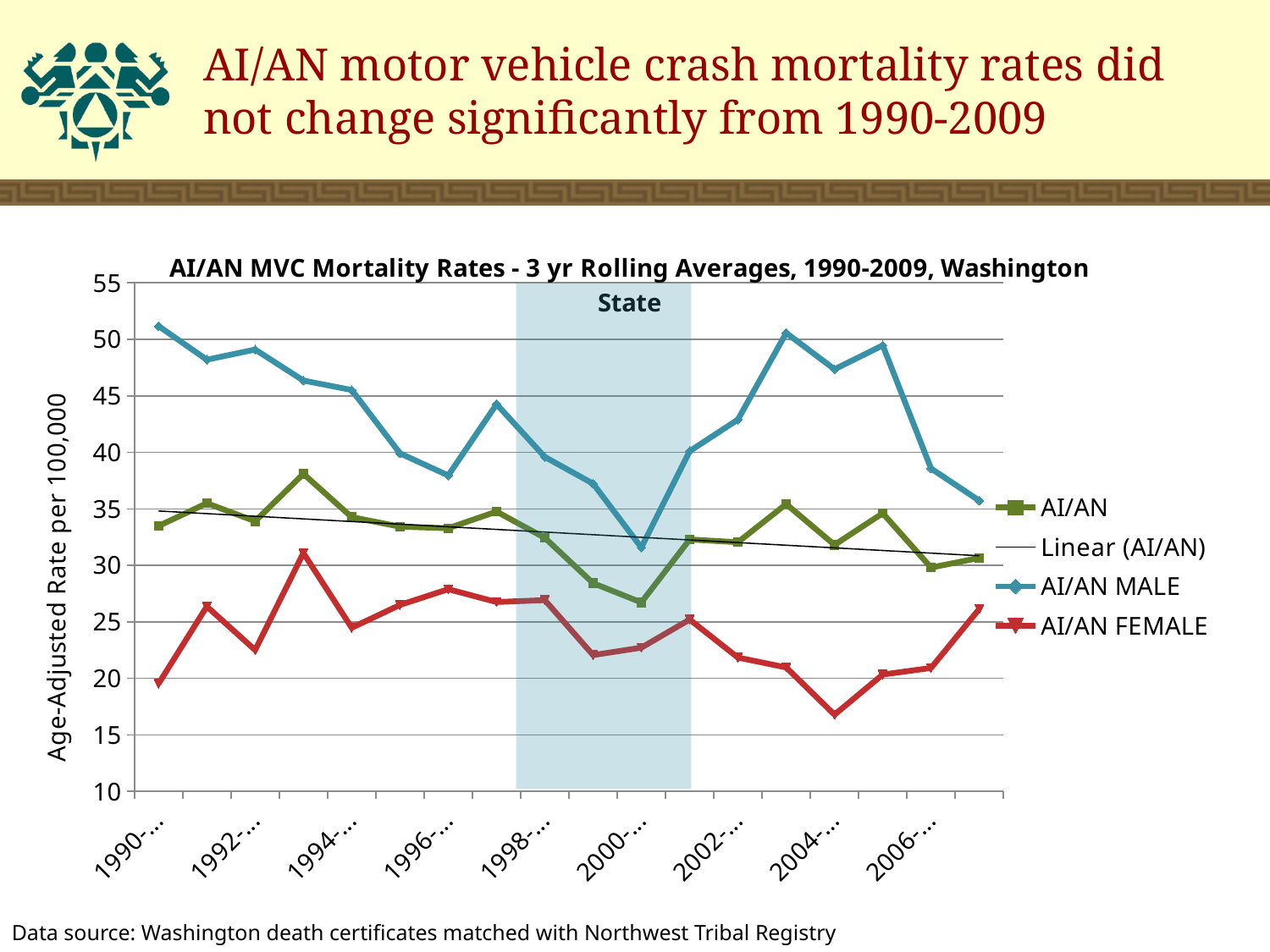
Which series has the lowest values throughout the chart? AI/AN FEMALE Is the AI/AN MALE value for the 1990 period greater or less than 45? greater How many entries does the chart legend list? 4 What kind of chart is shown on the slide? line chart What is the label of the vertical axis? Age-Adjusted Rate per 100,000 Does the Linear (AI/AN) trend line rise or fall from left to right? fall Which series has the highest values throughout the chart? AI/AN MALE In which period does the AI/AN FEMALE series reach its lowest value? 2004 Is the AI/AN MALE value for the 2000 period greater or less than 35? less Is the AI/AN FEMALE value for the 1990 period greater or less than 25? less What is the title of the chart? AI/AN MVC Mortality Rates - 3 yr Rolling Averages, 1990-2009, Washington State